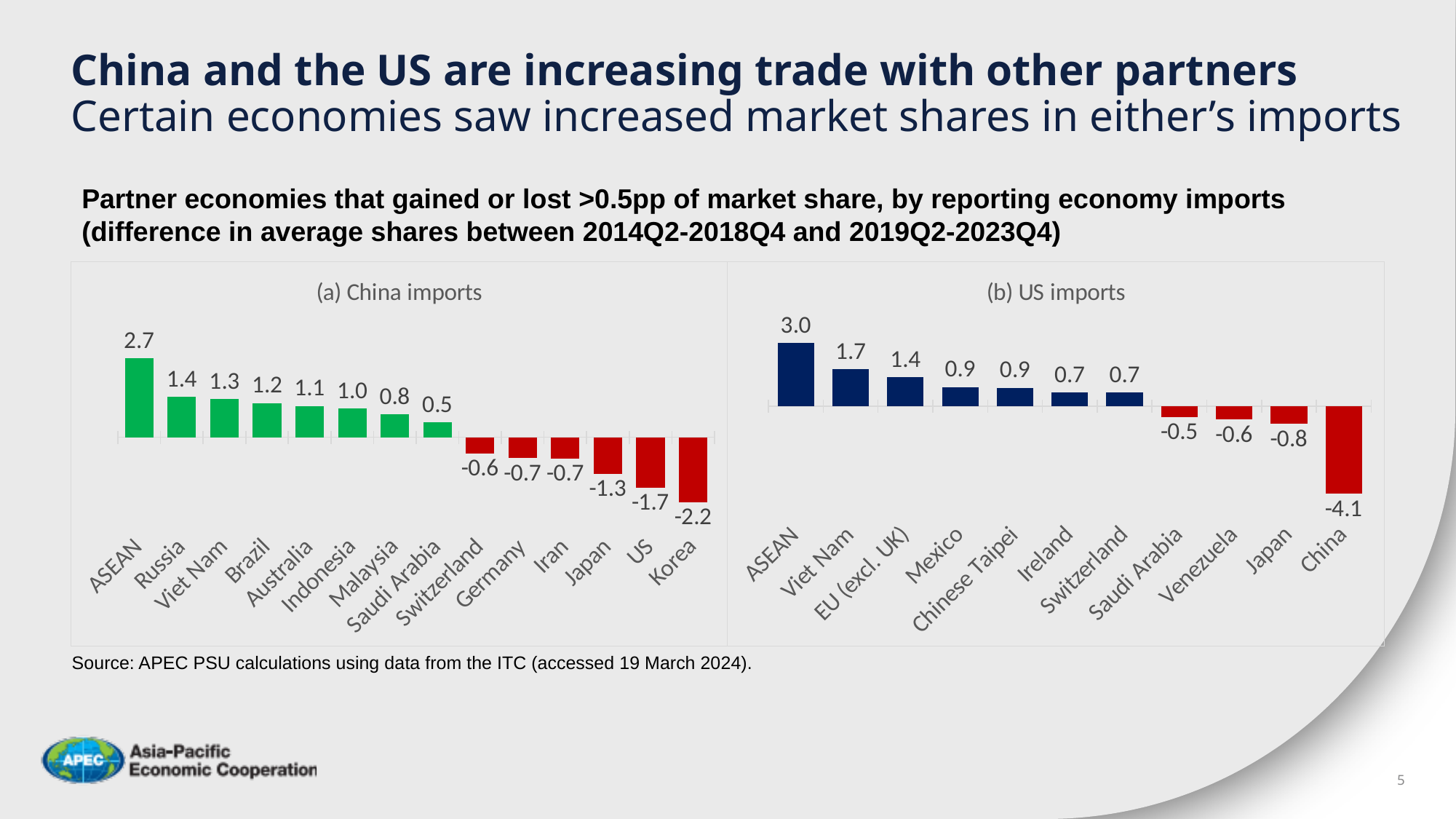
In the '(a) China imports' chart, what colour are the bars with negative values? Red In the '(a) China imports' chart, which category has the highest value? ASEAN How many categories are shown in the '(b) US imports' chart? 11 In the '(b) US imports' chart, which category has the lowest value? China What kind of chart is the '(b) US imports' chart? Bar chart In the '(a) China imports' chart, what is the value for Korea? -2.2 In the '(a) China imports' chart, what is the value for ASEAN? 2.7 In the '(b) US imports' chart, what is the value for China? -4.1 In the '(b) US imports' chart, what is the value for Viet Nam? 1.7 In the '(b) US imports' chart, which is larger, the value for Mexico or the value for Ireland? Mexico How many categories are shown in the '(a) China imports' chart? 14 In the '(a) China imports' chart, what is the difference between the values for ASEAN and Russia? 1.3